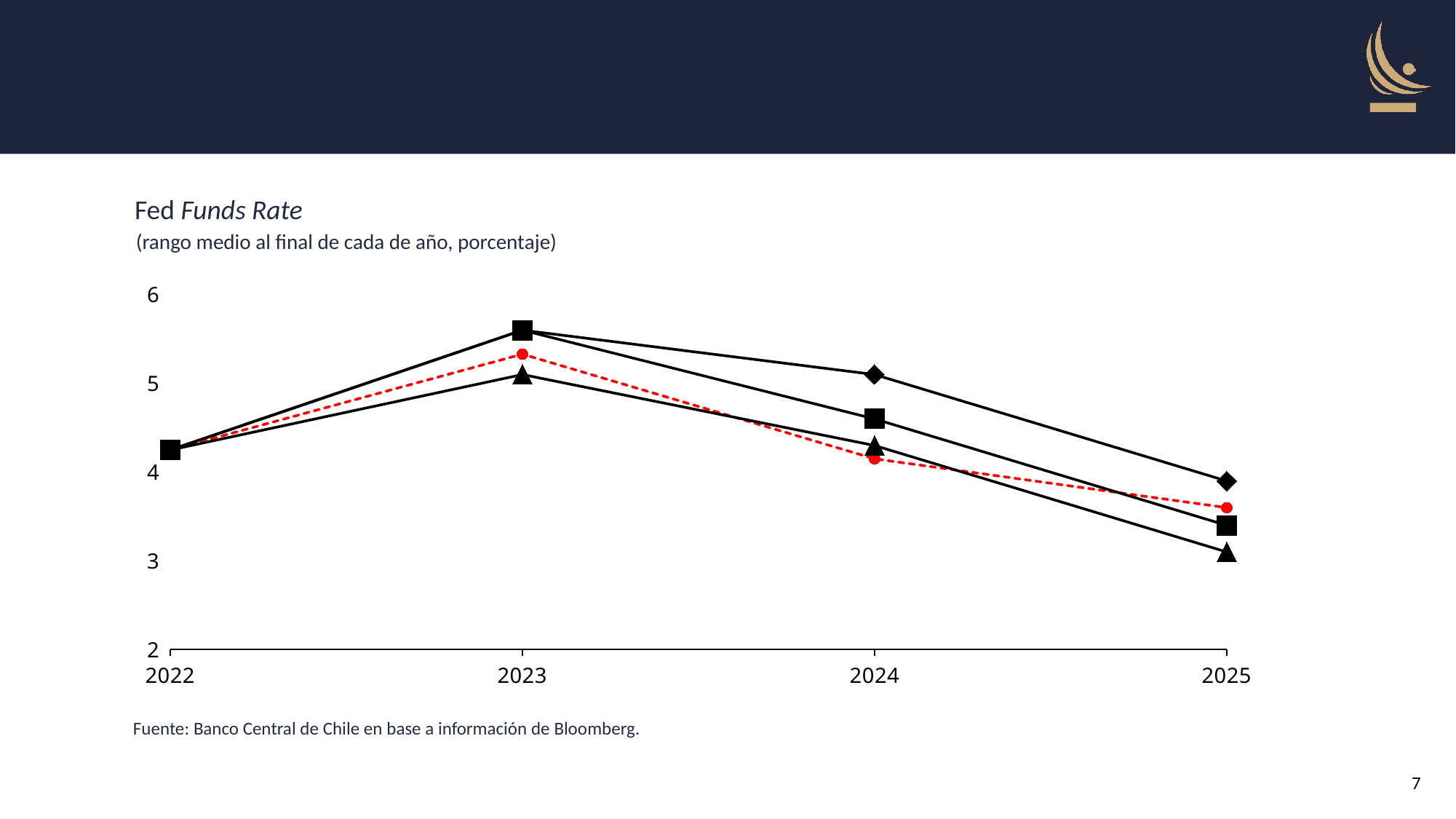
Is the value of the square-marker line in 2023 greater or less than 5? greater What kind of chart is shown on the slide? line chart How many years are shown on the x axis? 4 In 2025, which line has the higher value: the diamond-marker line or the triangle-marker line? the diamond-marker line How many lines are plotted on the chart? 4 Is the value of the triangle-marker line in 2025 greater or less than 4? less In which year does the square-marker line reach its highest value? 2023 What is the title of the chart? Fed Funds Rate Is the value of the red dotted line in 2024 greater or less than 5? less In which year does the square-marker line reach its lowest value? 2025 Do the values of the lines rise or fall from 2023 to 2025? fall